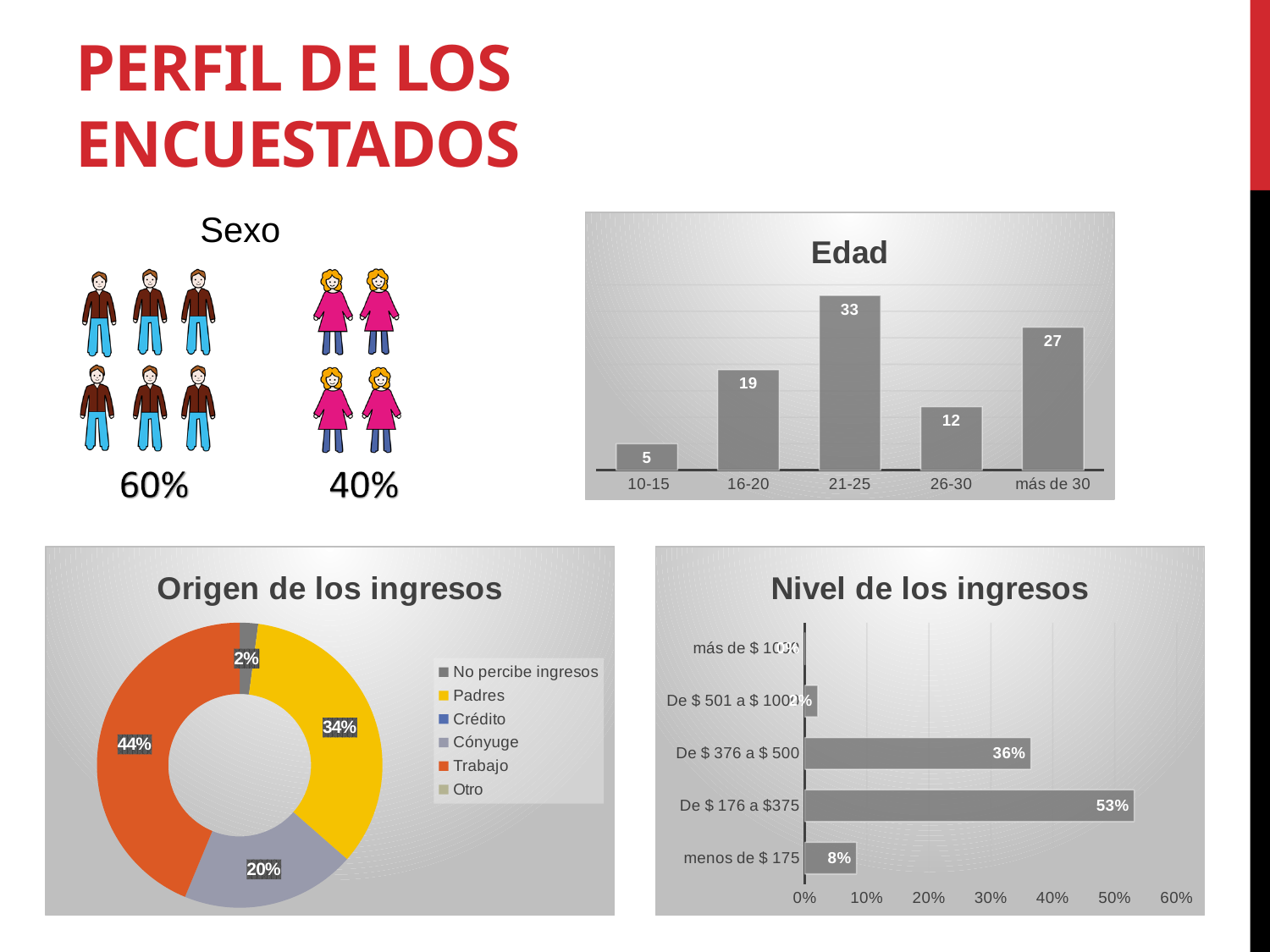
In the 'Edad' chart, how many age groups are shown? 5 In the 'Nivel de los ingresos' chart, what is the value for 'De $ 176 a $375'? 53% What kind of chart is 'Nivel de los ingresos'? bar chart In the 'Edad' chart, which age group has the highest value? 21-25 In the 'Origen de los ingresos' chart, how many entries does the legend list? 6 In the 'Edad' chart, which is larger: the value for 16-20 or the value for más de 30? más de 30 In the 'Edad' chart, what is the value for the 21-25 age group? 33 In the 'Edad' chart, what is the difference between the values for 21-25 and 26-30? 21 In the 'Origen de los ingresos' chart, what share is labelled for Padres? 34% In the 'Nivel de los ingresos' chart, what is the difference between the values for 'De $ 176 a $375' and 'De $ 376 a $ 500'? 17% In the 'Edad' chart, which age group has the lowest value? 10-15 In the 'Origen de los ingresos' chart, what share is labelled for Trabajo? 44%